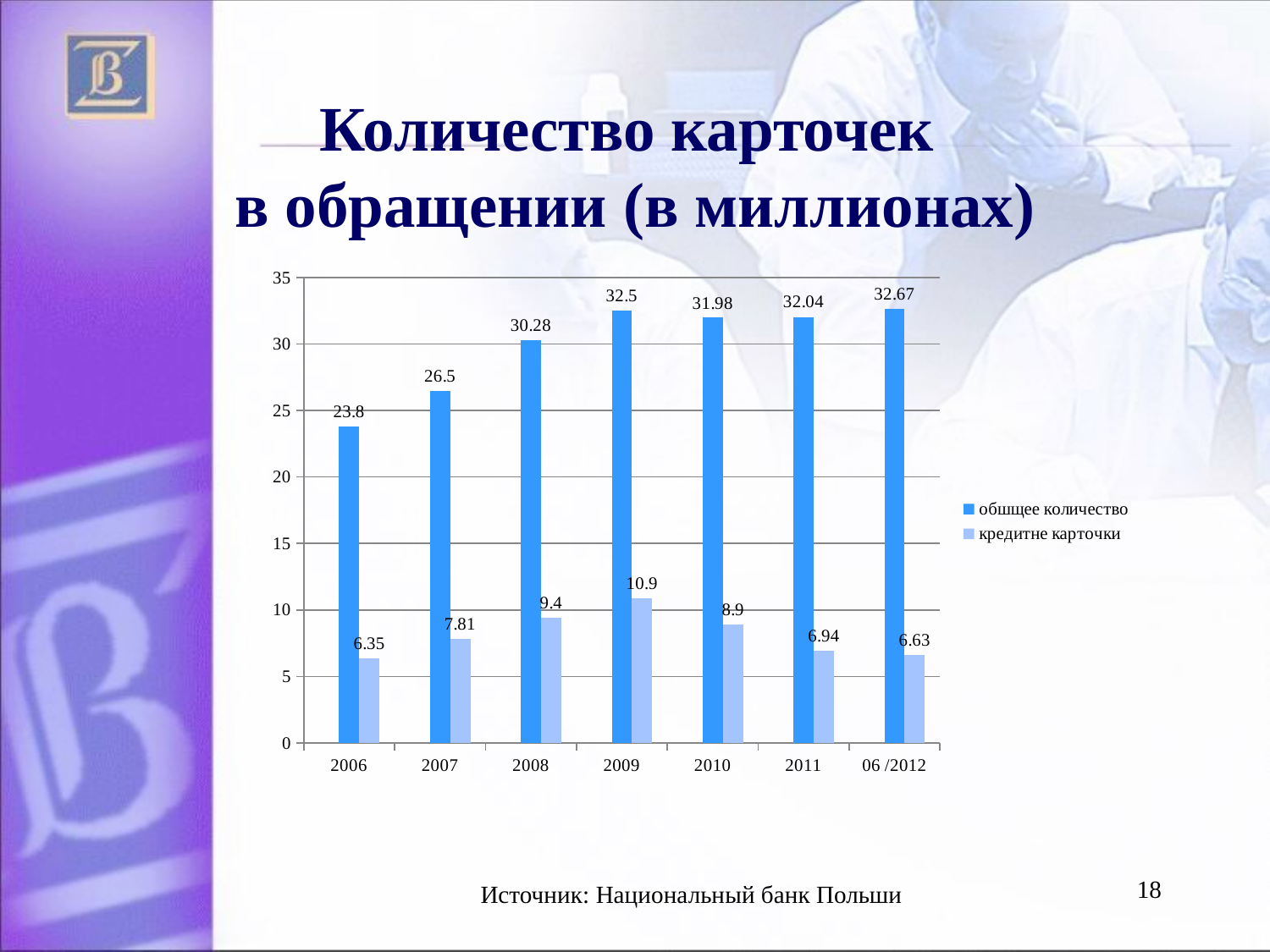
Which year has the lowest value for the 'кредитне карточки' series? 2006 What is the value of the 'кредитне карточки' series for 2009? 10.9 What is the difference between the 'обшщее количество' values for 2007 and 2006? 2.7 Which is larger: the 'кредитне карточки' value for 2010 or for 2011? 2010 What is the value of the 'кредитне карточки' series for 06 /2012? 6.63 Is the 'обшщее количество' value for 2006 greater or less than 25? less Does the 'кредитне карточки' series rise or fall from 2009 to 06 /2012? fall How many series does the legend list? 2 Which year has the highest value for the 'обшщее количество' series? 06 /2012 How many categories are shown on the x axis? 7 What is the value of the 'обшщее количество' series for 2008? 30.28 What kind of chart is shown on the slide? bar chart